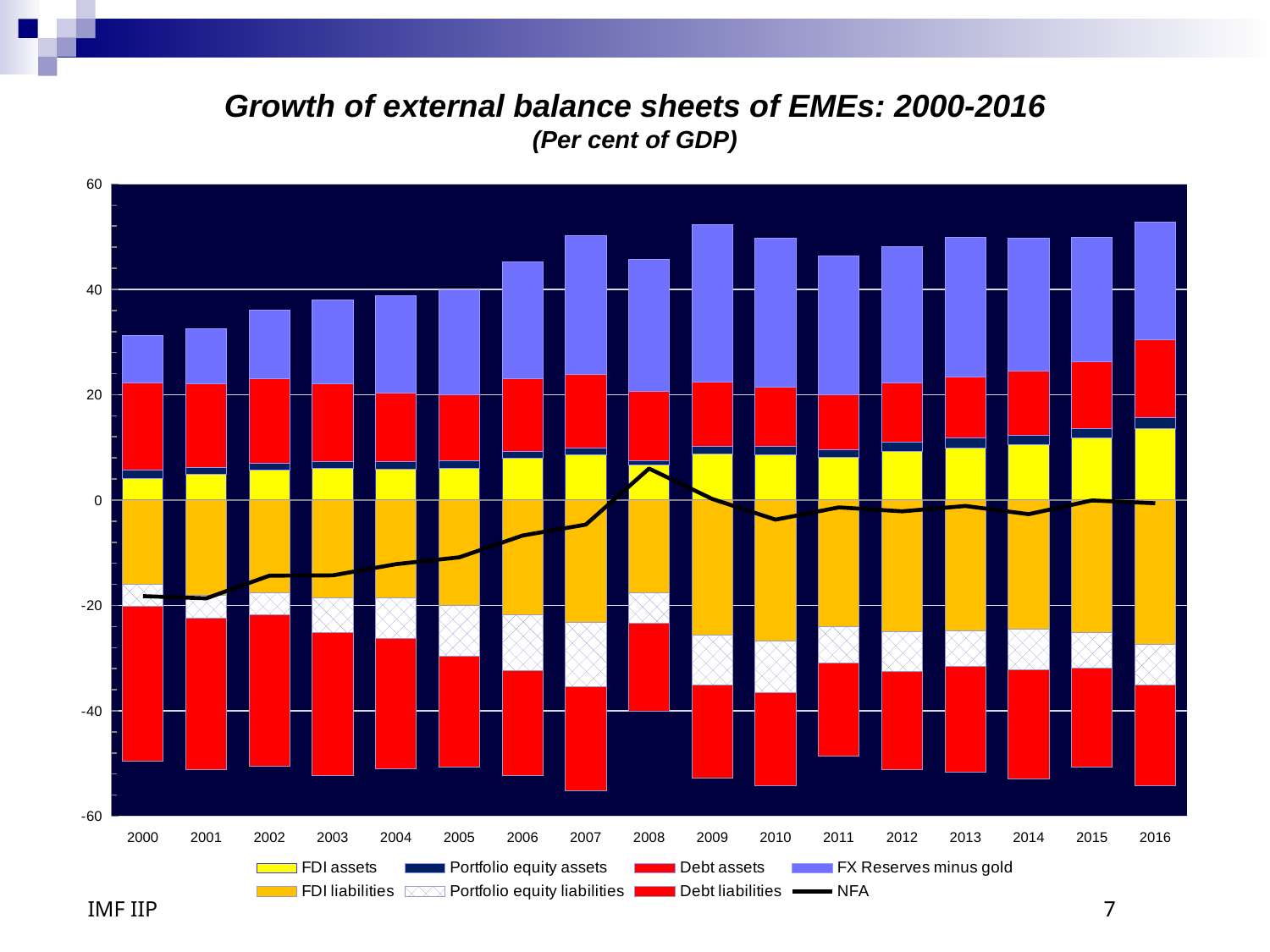
Is the top of the positive (assets) stack for 2000 greater or less than 40? less What kind of chart is shown on the slide? Stacked bar chart with a line Does the NFA line rise or fall between 2000 and 2008? rises Is the NFA value for 2008 greater or less than 0? greater What is the title of the chart? Growth of external balance sheets of EMEs: 2000-2016 Is the bottom of the negative (liabilities) stack for 2007 greater or less than -40? less How many series does the chart's legend list? 8 Which series is drawn as a black line in the chart? NFA Which year has the larger positive (assets) stack, 2000 or 2016? 2016 How many years are shown along the x axis of the chart? 17